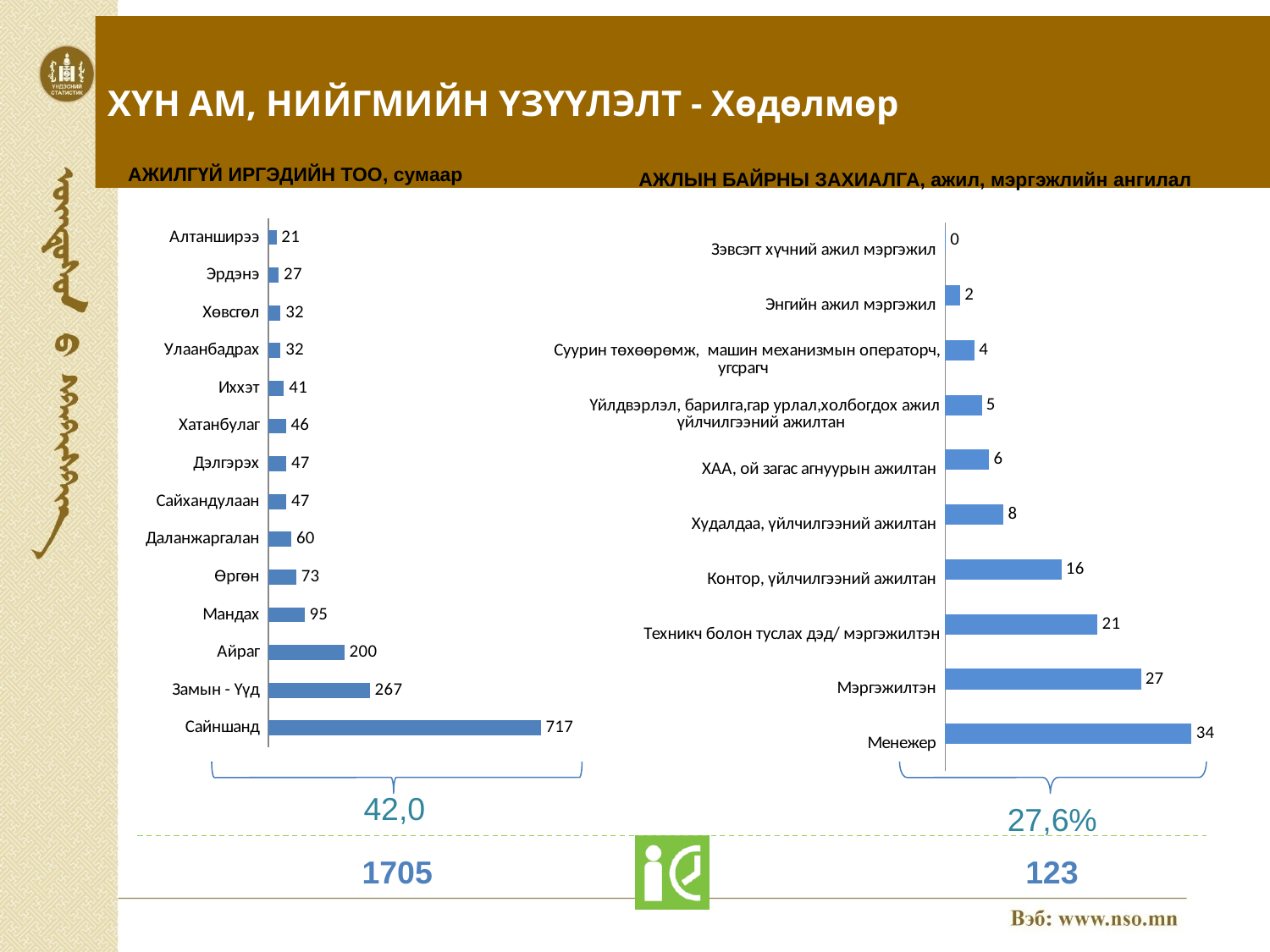
In the left chart (АЖИЛГҮЙ ИРГЭДИЙН ТОО, сумаар), which category has the lowest value? Алтанширээ In the left chart (АЖИЛГҮЙ ИРГЭДИЙН ТОО, сумаар), how many categories are shown? 14 What type of chart is the left chart (АЖИЛГҮЙ ИРГЭДИЙН ТОО, сумаар)? Bar chart In the left chart (АЖИЛГҮЙ ИРГЭДИЙН ТОО, сумаар), what is the value for Сайншанд? 717 In the right chart (АЖЛЫН БАЙРНЫ ЗАХИАЛГА), what is the difference between Мэргэжилтэн and Техникч болон туслах дэд/ мэргэжилтэн? 6 In the left chart (АЖИЛГҮЙ ИРГЭДИЙН ТОО, сумаар), what is the value for Мандах? 95 In the left chart (АЖИЛГҮЙ ИРГЭДИЙН ТОО, сумаар), what is the difference between Замын - Үүд and Айраг? 67 In the right chart (АЖЛЫН БАЙРНЫ ЗАХИАЛГА), what is the value for Контор, үйлчилгээний ажилтан? 16 In the right chart (АЖЛЫН БАЙРНЫ ЗАХИАЛГА), which category has the highest value? Менежер In the right chart (АЖЛЫН БАЙРНЫ ЗАХИАЛГА), how many categories are shown? 10 In the left chart (АЖИЛГҮЙ ИРГЭДИЙН ТОО, сумаар), which is larger, Өргөн or Даланжаргалан? Өргөн In the right chart (АЖЛЫН БАЙРНЫ ЗАХИАЛГА), what is the value for Менежер? 34